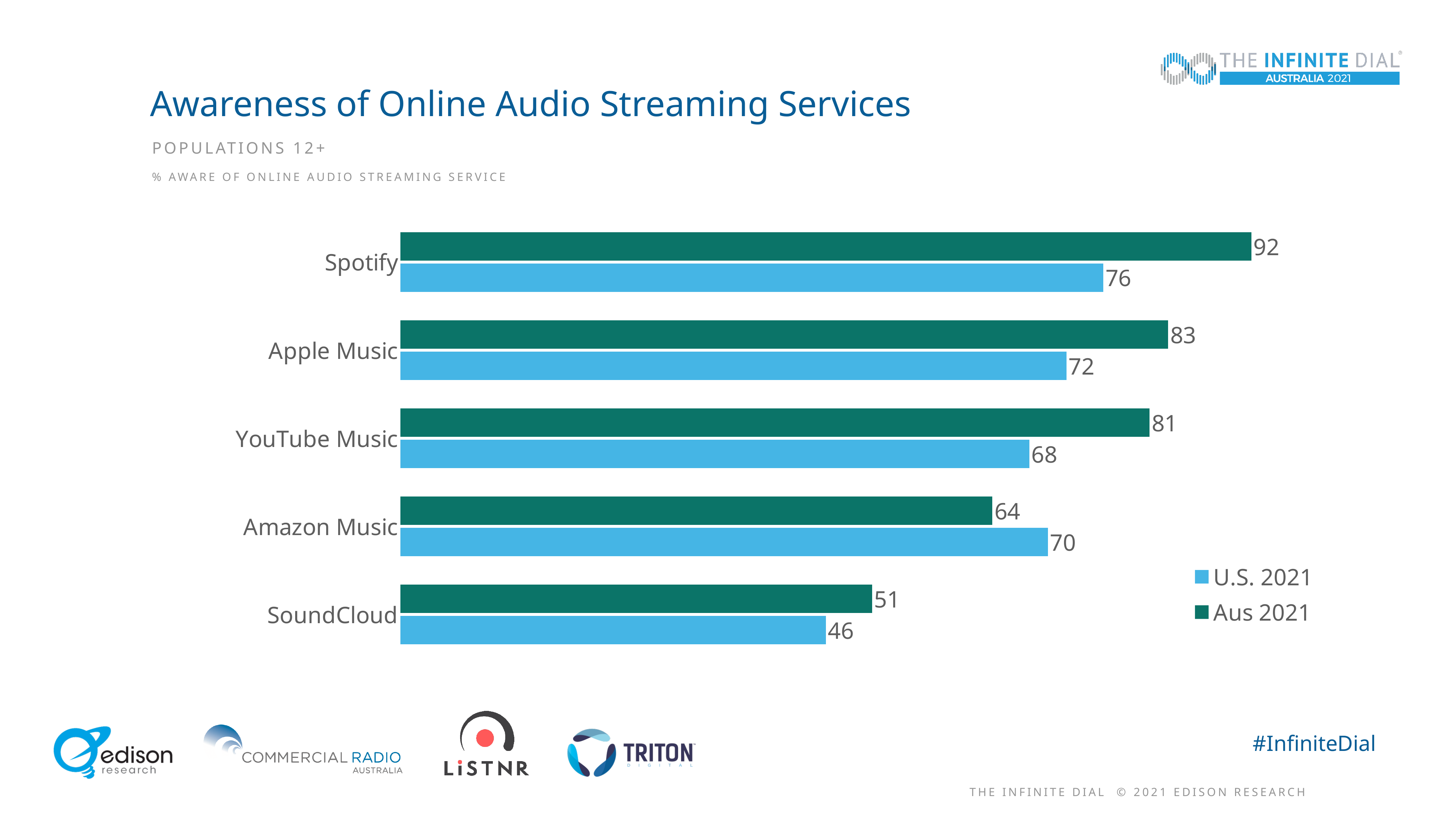
What kind of chart is shown on the slide? Bar chart What is the difference between the Aus 2021 and U.S. 2021 values for Spotify? 16 Which service has the lowest U.S. 2021 awareness? SoundCloud What is the difference between the Aus 2021 and U.S. 2021 values for YouTube Music? 13 Which service has the highest Aus 2021 awareness? Spotify What is the U.S. 2021 value for Amazon Music? 70 What is the Aus 2021 value for Spotify? 92 What is the title of the chart? Awareness of Online Audio Streaming Services How many series does the legend list? 2 What is the U.S. 2021 value for SoundCloud? 46 For Amazon Music, which is larger: the U.S. 2021 value or the Aus 2021 value? U.S. 2021 How many streaming services are shown in the chart? 5